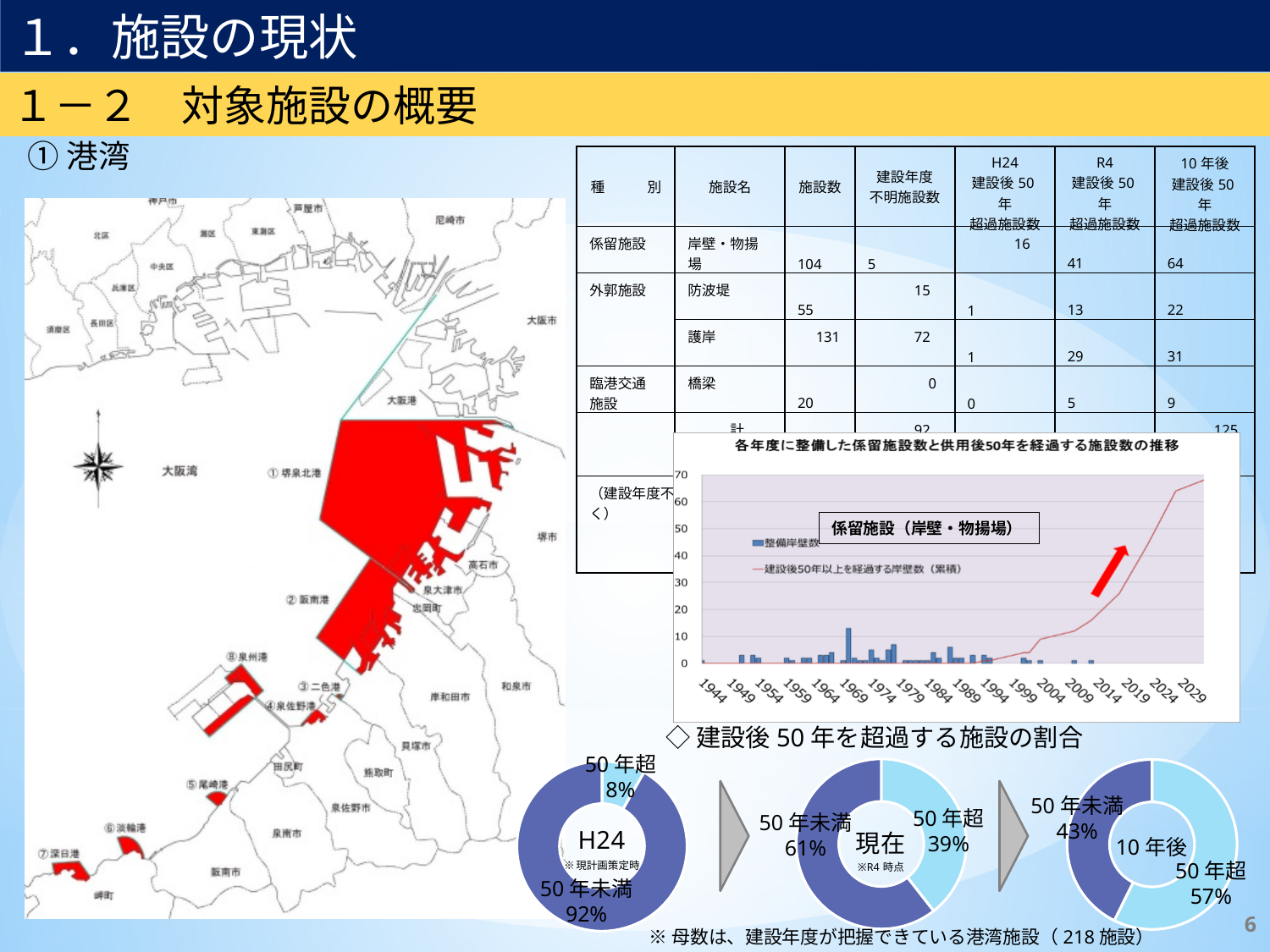
Across the three donut charts (H24, 現在, 10年後), does the 50年超 share rise or fall over time? rise What is the difference between the 50年超 share in the 10年後 donut chart and the 50年超 share in the H24 donut chart? 49 percentage points In the chart titled 各年度に整備した係留施設数と供用後50年を経過する施設数の推移, is the value of the 建設後50年以上を経過する岸壁数（累積） line at 2029 greater or less than 60? greater In the chart titled 各年度に整備した係留施設数と供用後50年を経過する施設数の推移, does the 建設後50年以上を経過する岸壁数（累積） line rise or fall from 1994 to 2029? rise How many series does the legend of the chart titled 各年度に整備した係留施設数と供用後50年を経過する施設数の推移 list? 2 In the 現在 donut chart, what share of facilities is labelled 50年未満? 61% In the H24 donut chart, what share of facilities is labelled 50年未満? 92% What kind of chart is used to show the 建設後50年を超過する施設の割合 for H24, 現在 and 10年後? donut (pie) chart In the 現在 donut chart, what share of facilities is labelled 50年超? 39% In the 10年後 donut chart, which segment is larger, 50年超 or 50年未満? 50年超 In the H24 donut chart, what share of facilities is labelled 50年超? 8% In the 10年後 donut chart, what share of facilities is labelled 50年超? 57%